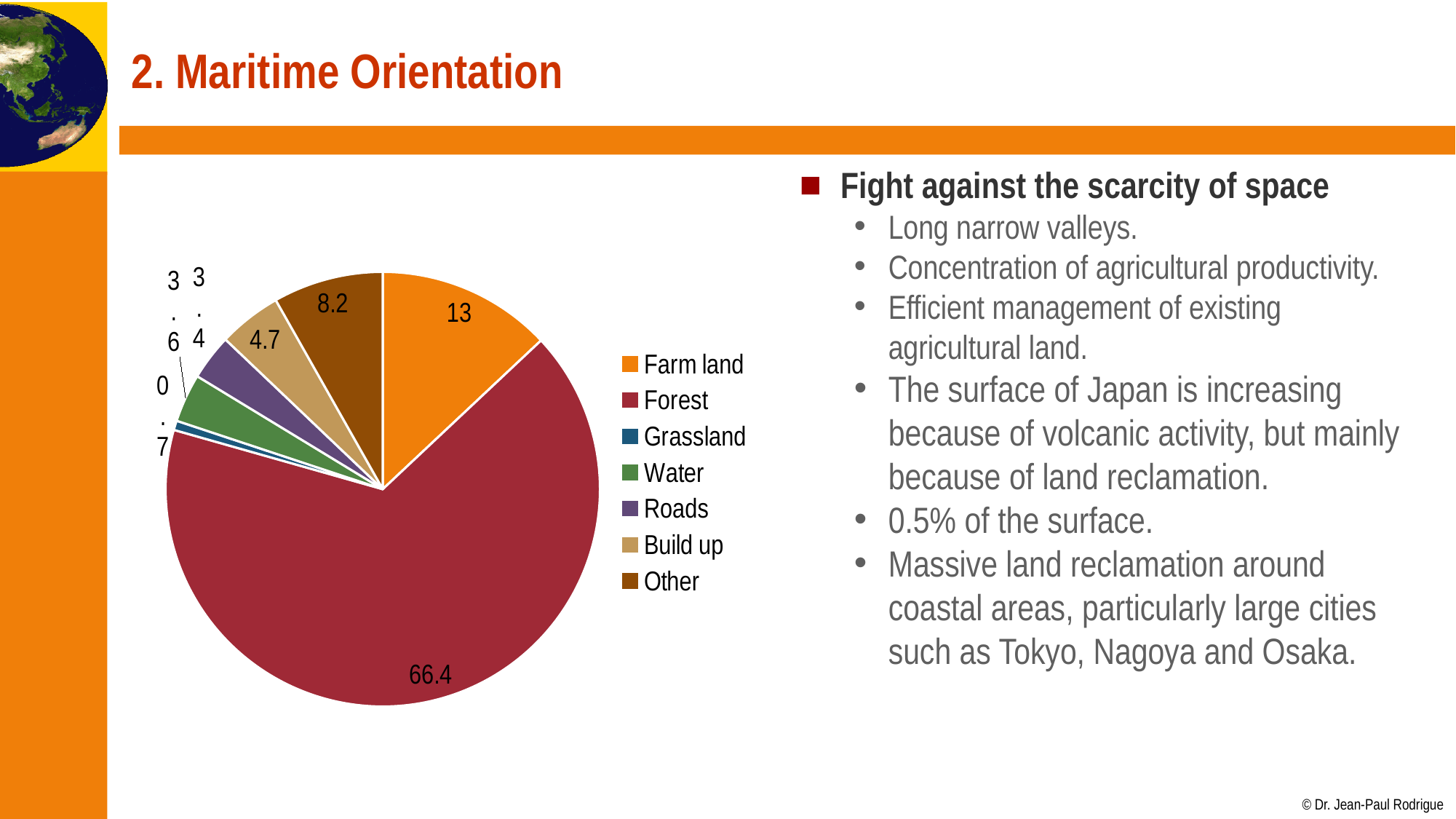
What is the difference between the Forest and Farm land values in the pie chart? 53.4 What is the value for Build up in the pie chart? 4.7 What colour is the Forest slice in the pie chart? dark red What is the value for Other in the pie chart? 8.2 What is the value for Farm land in the pie chart? 13 How many categories does the pie chart legend list? 7 What is the difference between the Other and Build up values in the pie chart? 3.5 What is the value for Forest in the pie chart? 66.4 Which is larger in the pie chart, Farm land or Other? Farm land Which category has the smallest slice in the pie chart? Grassland What type of chart is shown on the slide? pie chart Which category has the largest slice in the pie chart? Forest